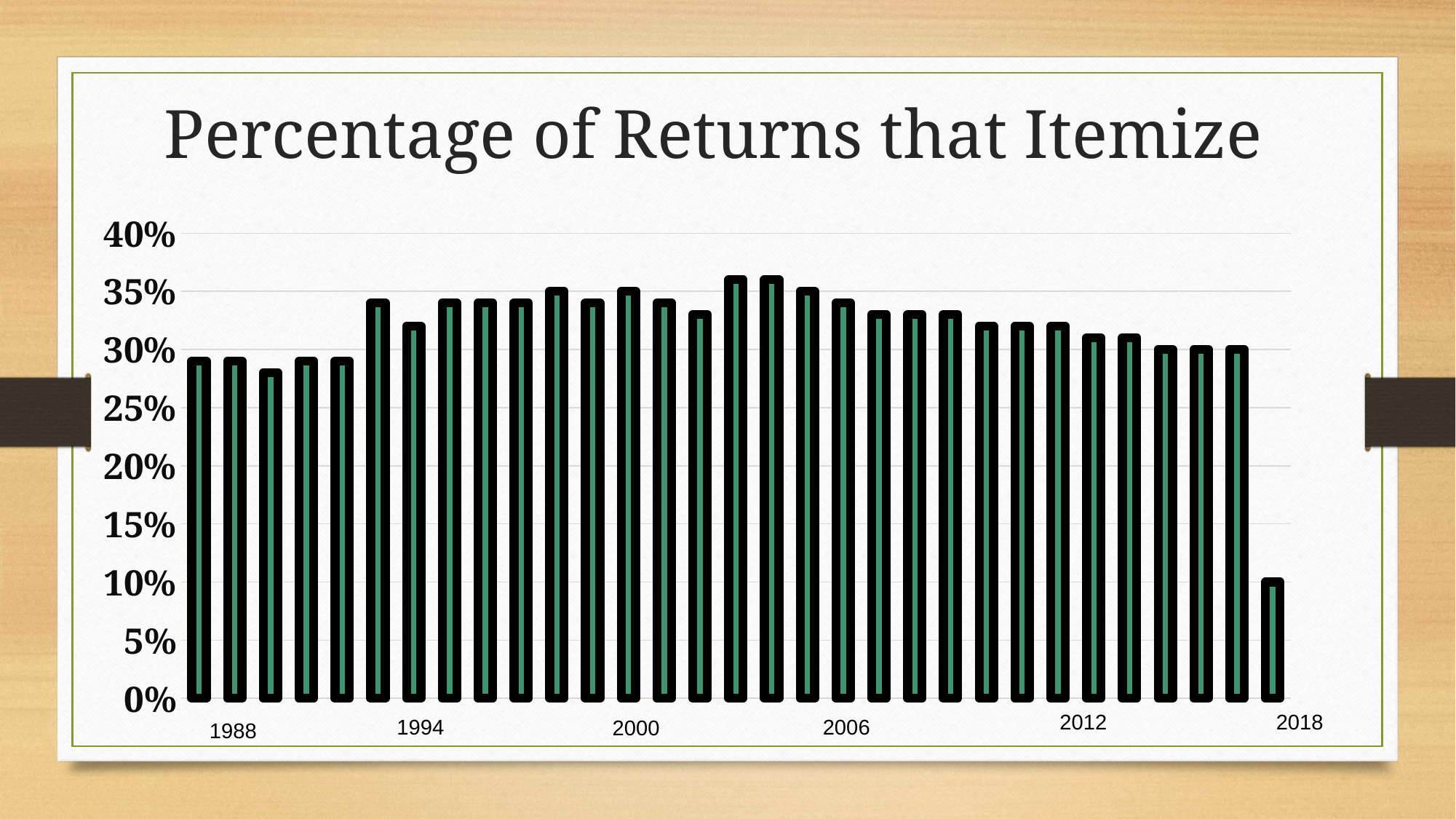
Which year has the lowest percentage of returns that itemize? 2018 What kind of chart is shown on the slide? Bar chart Do the values generally rise or fall from 2012 to 2018? fall What is the title of the chart? Percentage of Returns that Itemize Is the value for 2006 greater or less than 35%? less Is the value for 2012 greater or less than 30%? greater How many bars (years) are plotted in the chart? 31 Which is larger, the value for 1988 or the value for 2018? 1988 What is the highest value shown on the vertical axis? 40% Which is larger, the value for 1994 or the value for 1988? 1994 Is the value for 2018 greater or less than 15%? less